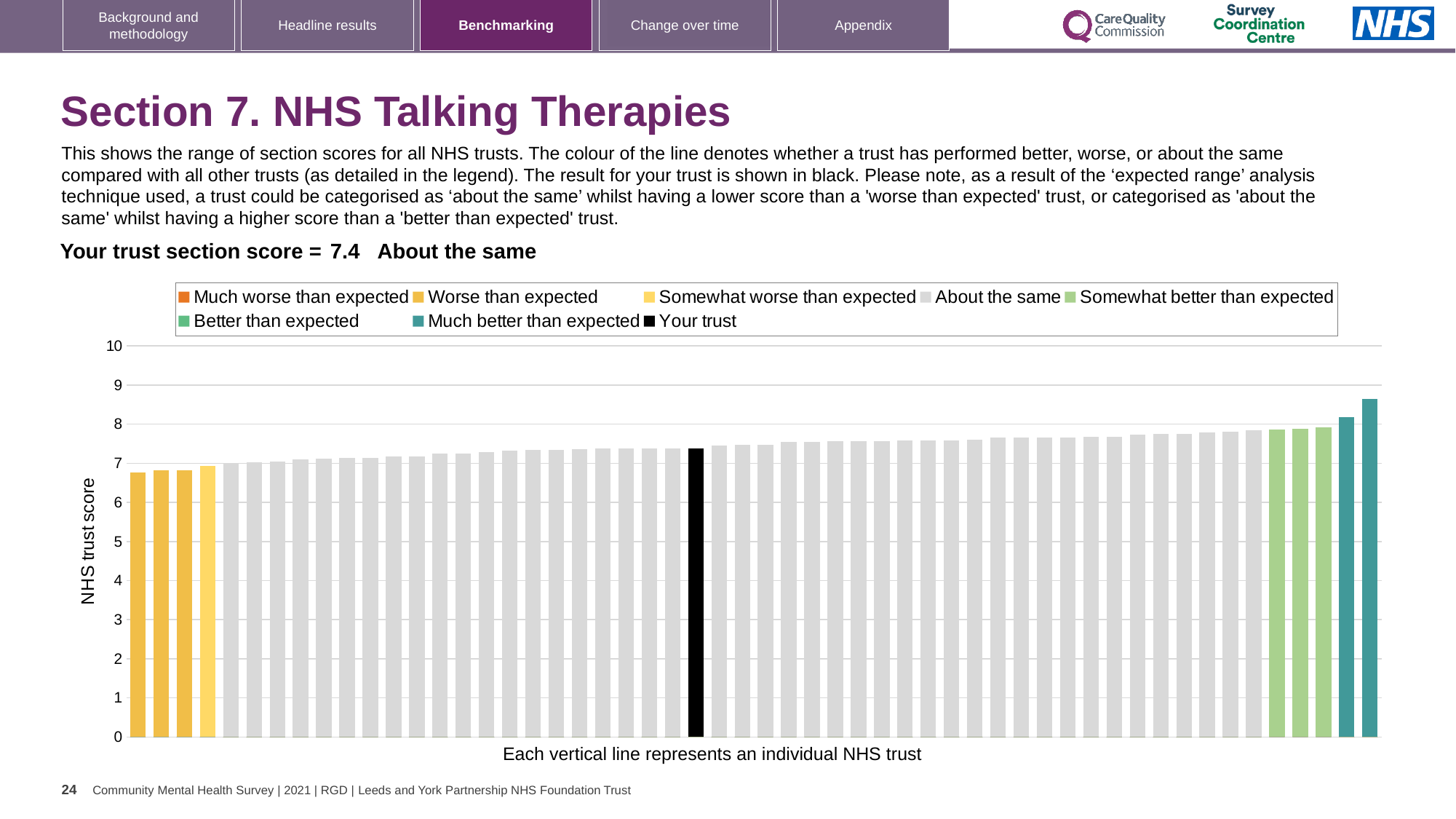
Is the value of the tallest bar in the chart greater or less than 8? greater Which legend category does the tallest bar belong to? Much better than expected What kind of chart is shown on the slide? bar chart Is the value for your trust (the black bar) greater or less than 7? greater What is the section score for your trust shown on the slide? 7.4 How many entries does the chart legend list? 8 Which category is your trust placed in according to the slide? About the same Is the value of the shortest bar in the chart greater or less than 7? less What is the label on the vertical axis of the chart? NHS trust score Which legend category does the shortest bar belong to? Worse than expected Do the bar values rise or fall from left to right along the x axis? rise What colour is the bar representing your trust? black